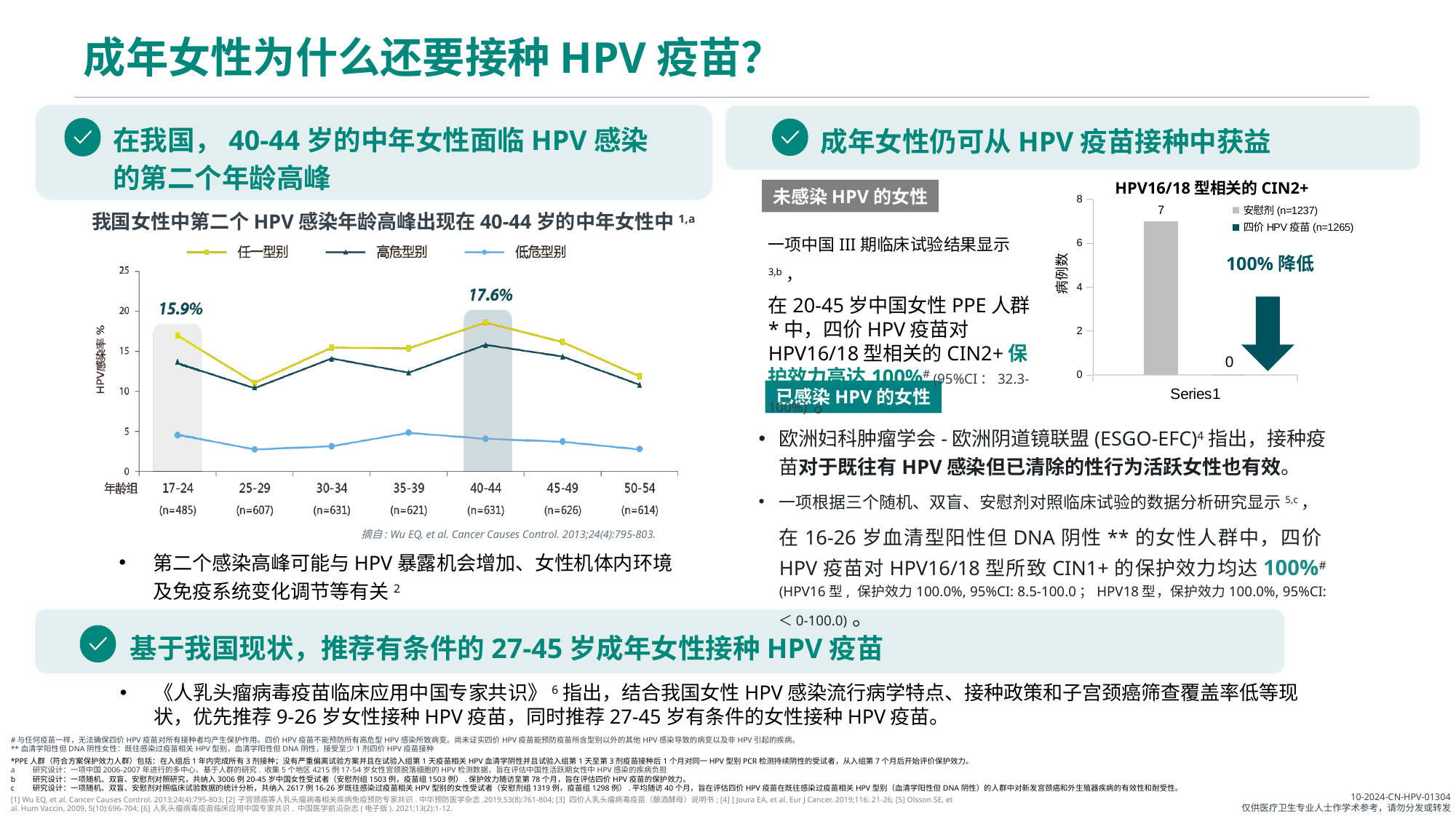
On the left line chart, which series has the lowest values across all age groups? 低危型别 On the left line chart, how many series does the legend list? 3 What kind of chart is the chart titled HPV16/18 型相关的 CIN2+? bar chart On the left line chart, what is the labelled HPV infection rate for 任一型别 in the 40-44 age group? 17.6% On the left line chart, how many age groups are shown on the x axis? 7 On the left line chart, is the value for 高危型别 in the 40-44 age group greater or less than 10? greater On the right bar chart titled HPV16/18 型相关的 CIN2+, what is the number of cases for 四价 HPV 疫苗 (n=1265)? 0 On the left line chart, what is the labelled HPV infection rate for 任一型别 in the 17-24 age group? 15.9% On the right bar chart titled HPV16/18 型相关的 CIN2+, what is the difference in cases between 安慰剂 and 四价 HPV 疫苗? 7 What kind of chart is the chart on the left of the slide? line chart On the left line chart, is the value for 低危型别 in the 35-39 age group greater or less than 10? less On the right bar chart titled HPV16/18 型相关的 CIN2+, what is the number of cases for 安慰剂 (n=1237)? 7